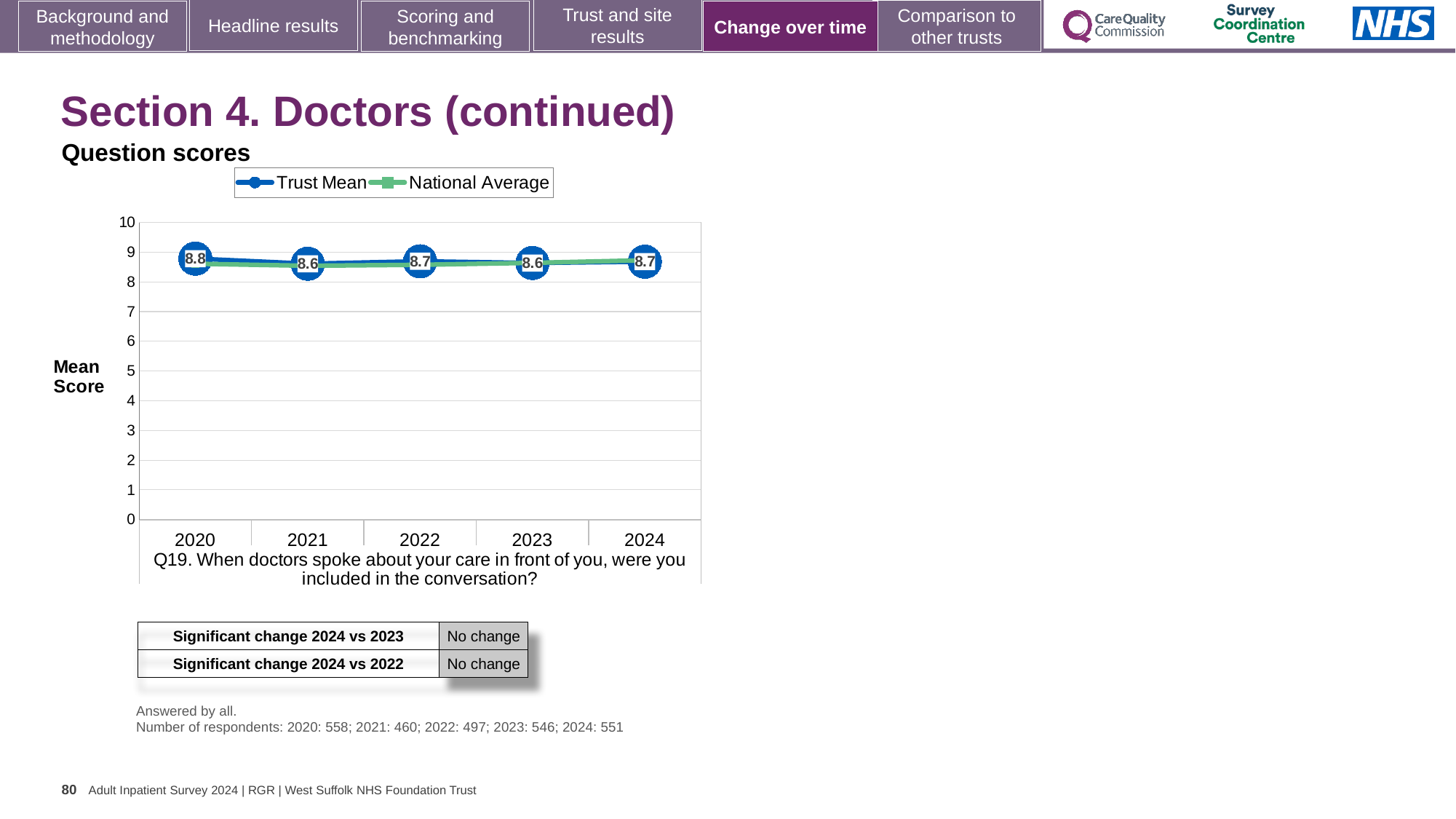
What is the Trust Mean score for 2020? 8.8 What is the Trust Mean score for 2024? 8.7 What kind of chart is shown on the slide? line chart What is the label of the y axis? Mean Score In which year was the Trust Mean score highest? 2020 What is the difference between the Trust Mean scores for 2020 and 2021? 0.2 How many years are plotted on the x axis? 5 What is the Trust Mean score for 2021? 8.6 What is the Trust Mean score for 2023? 8.6 Which year has the larger Trust Mean score, 2020 or 2023? 2020 Is the National Average value for 2024 greater or less than 8? greater How many series does the legend list? 2